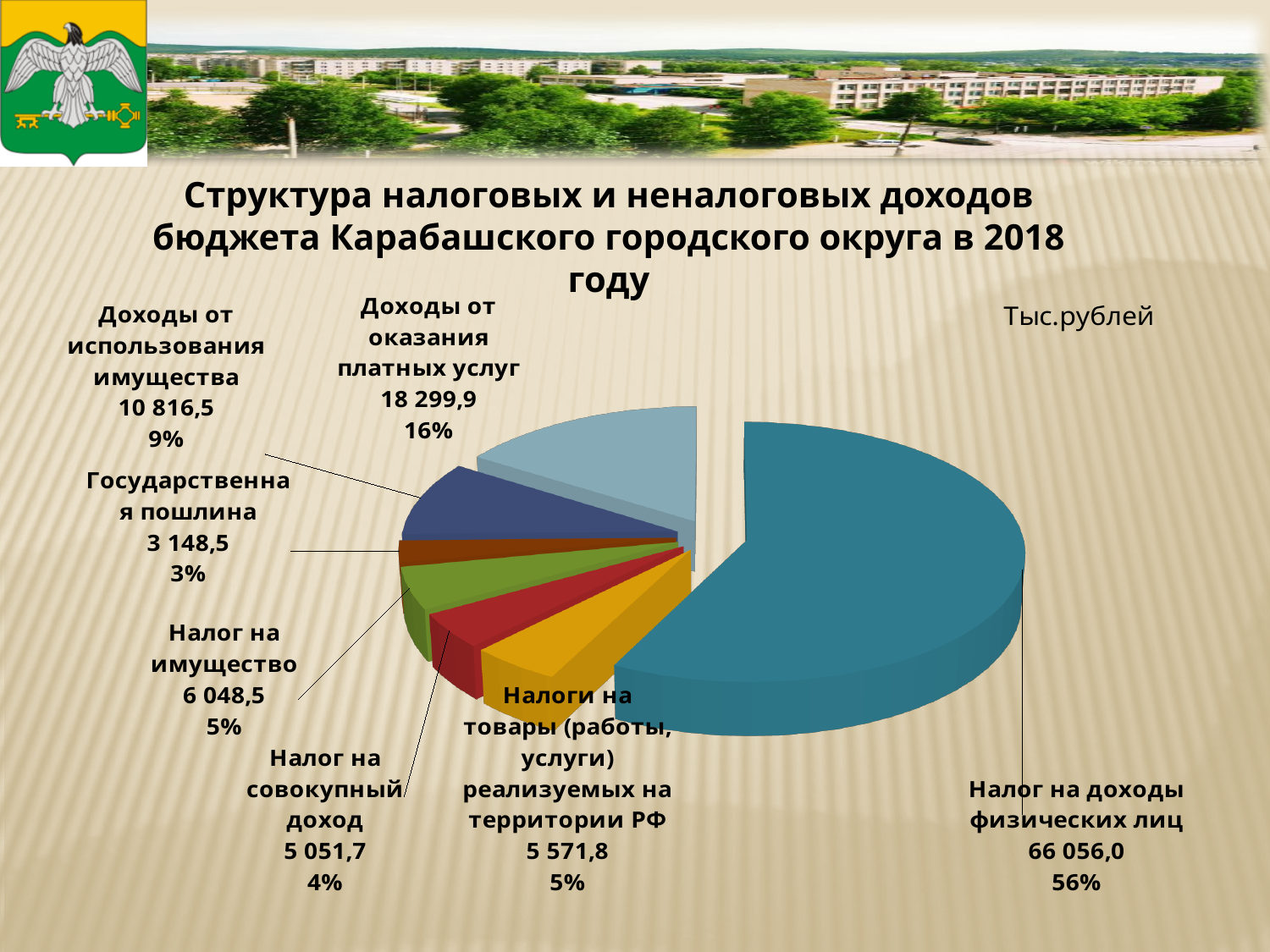
Which category has the largest slice of the pie? Налог на доходы физических лиц What share of the pie does Налог на совокупный доход represent? 4% Which category has the smallest slice of the pie? Государственная пошлина What is the value for Доходы от оказания платных услуг? 18 299,9 What is the difference between the values for Налог на доходы физических лиц and Доходы от оказания платных услуг? 47 756,1 What share of the pie does Доходы от использования имущества represent? 9% What is the value for Государственная пошлина? 3 148,5 Which is larger: the value for Налог на имущество or the value for Налоги на товары (работы, услуги) реализуемых на территории РФ? Налог на имущество What type of chart is shown on the slide? Pie chart What is the value for Налог на доходы физических лиц? 66 056,0 What unit is indicated for the values in the chart? Тыс.рублей How many categories are shown in the pie chart? 7